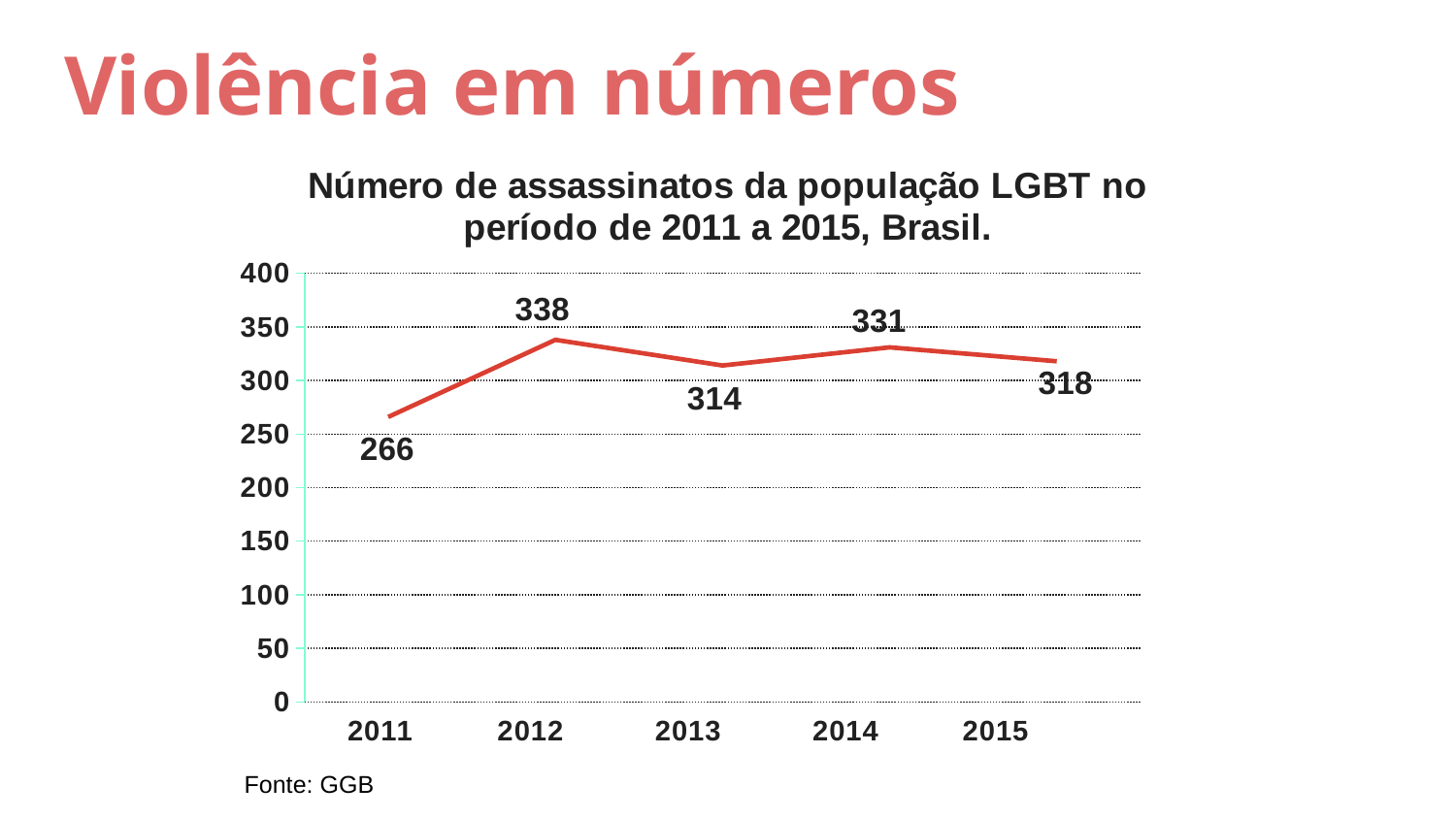
Which year has the highest value? 2012 Which year has the lowest value? 2011 Is the value for 2011 greater or less than 300? less What is the difference between the values for 2014 and 2013? 17 What is the difference between the values for 2012 and 2011? 72 What kind of chart is shown on the slide? line chart What is the value for 2015? 318 How many years are plotted on the chart? 5 Which is larger, the value for 2013 or the value for 2015? 2015 What is the number of murders shown for 2011? 266 What value is plotted for 2014? 331 What source is cited below the chart? GGB